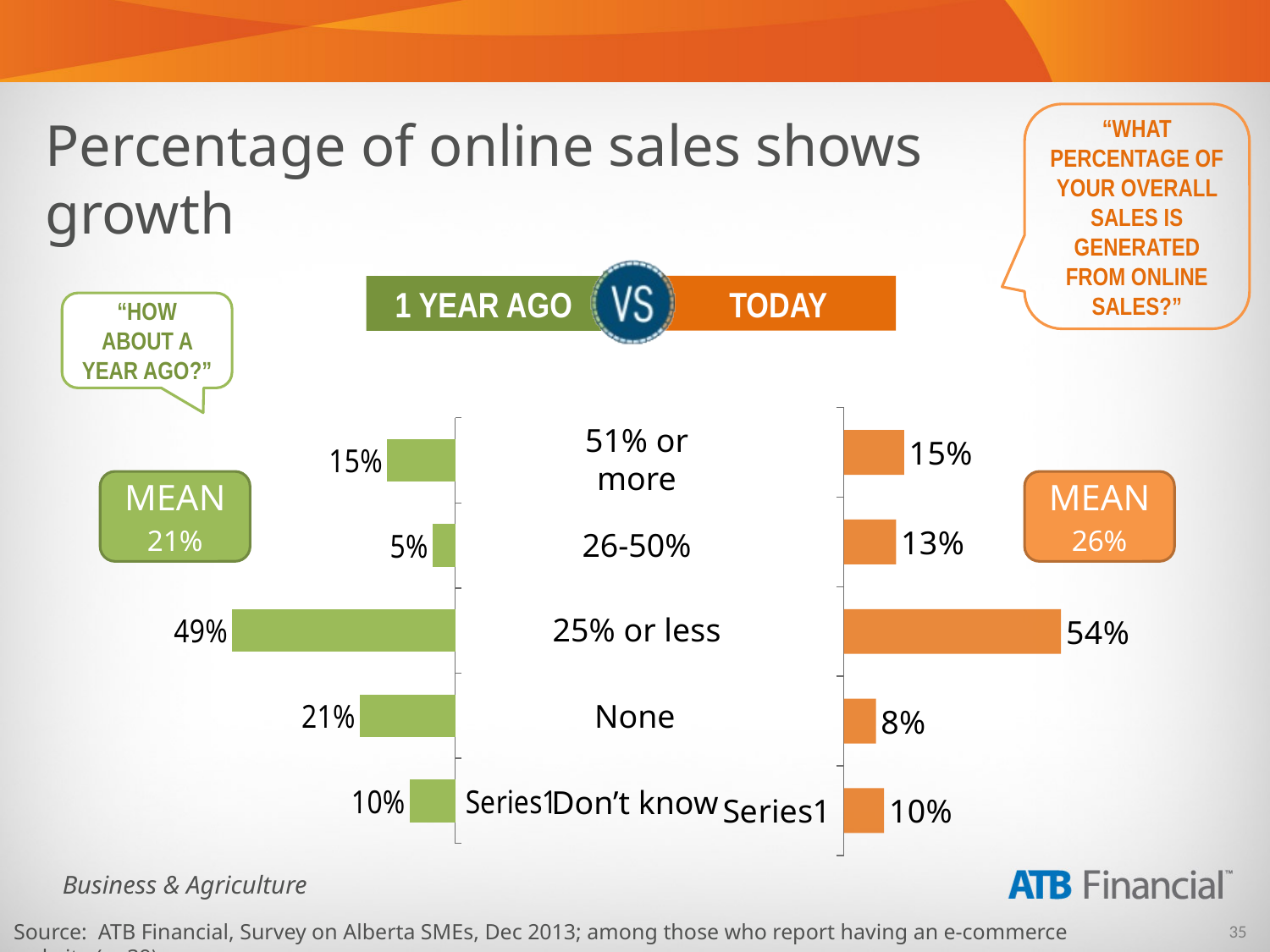
In the TODAY chart, what is the value for "None"? 8% What is the difference between the "25% or less" value in the TODAY chart and the "25% or less" value in the 1 YEAR AGO chart? 5% In the 1 YEAR AGO chart, what is the value for "25% or less"? 49% Which is larger: the "None" value in the 1 YEAR AGO chart or the "None" value in the TODAY chart? 1 YEAR AGO How many categories are shown in the TODAY chart? 5 What type of chart is the 1 YEAR AGO chart? Bar chart What is the mean shown next to the TODAY chart? 26% In the TODAY chart, what is the value for "26-50%"? 13% In the TODAY chart, which category has the lowest value? None In the 1 YEAR AGO chart, which category has the highest value? 25% or less What colour are the bars in the 1 YEAR AGO chart? Green In the 1 YEAR AGO chart, which category has the lowest value? 26-50%